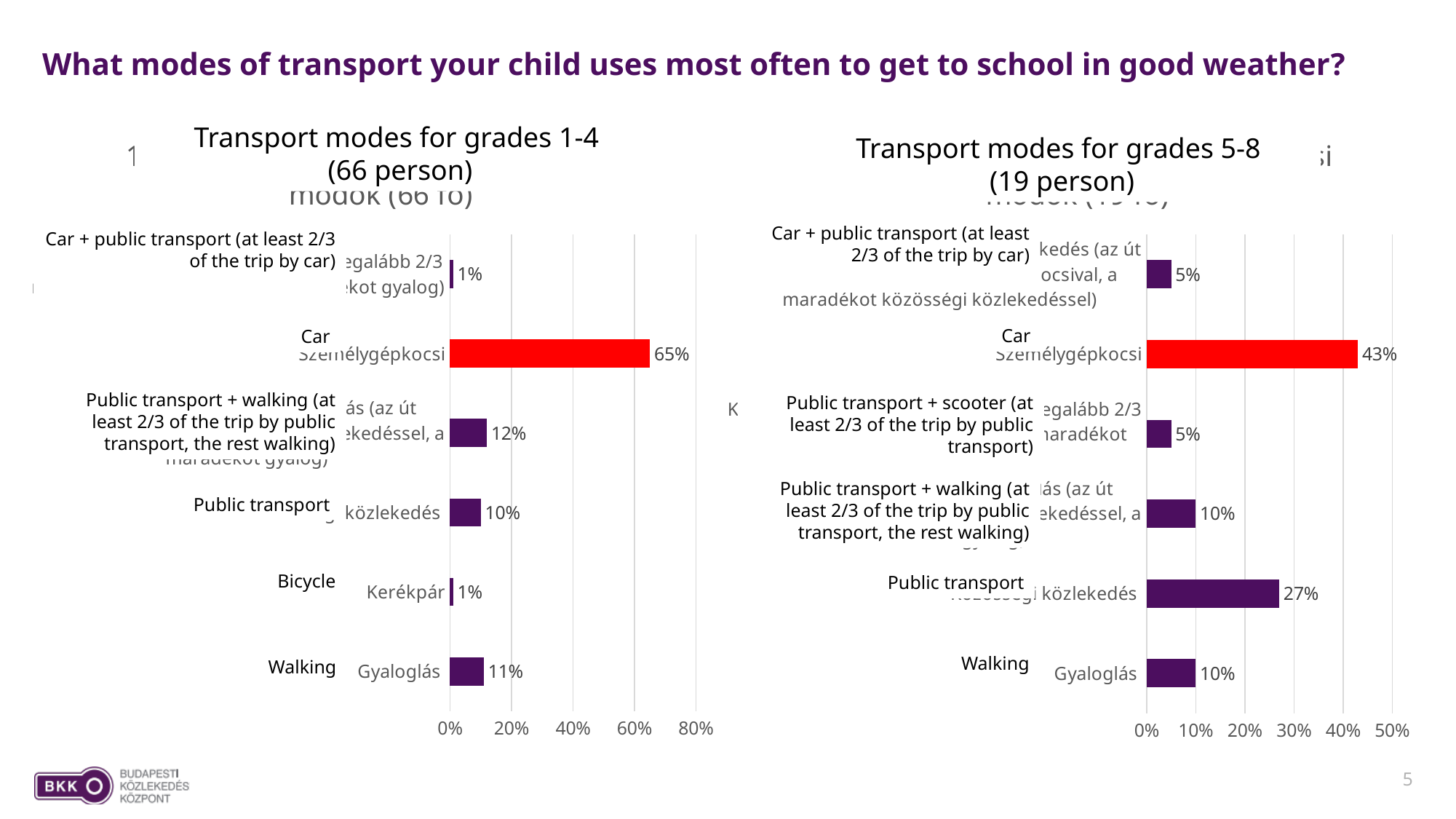
In the 'Transport modes for grades 5-8 (19 person)' chart, which category has the highest value? Car How many categories are shown in the 'Transport modes for grades 5-8 (19 person)' chart? 6 In the 'Transport modes for grades 1-4 (66 person)' chart, what colour is the bar for Car? Red In the 'Transport modes for grades 5-8 (19 person)' chart, what is the difference between the values for Car and Public transport? 16% In the 'Transport modes for grades 1-4 (66 person)' chart, what is the value for Car? 65% In the 'Transport modes for grades 1-4 (66 person)' chart, is the value for Car greater or less than 60%? greater In the 'Transport modes for grades 1-4 (66 person)' chart, which category has the highest value? Car What kind of chart is the 'Transport modes for grades 1-4 (66 person)' chart? Bar chart In the 'Transport modes for grades 1-4 (66 person)' chart, what is the value for Walking? 11% In the 'Transport modes for grades 5-8 (19 person)' chart, which is larger: the value for Public transport or the value for Walking? Public transport In the 'Transport modes for grades 5-8 (19 person)' chart, what is the value for Public transport? 27% In the 'Transport modes for grades 1-4 (66 person)' chart, what is the difference between the values for Public transport + walking and Public transport? 2%